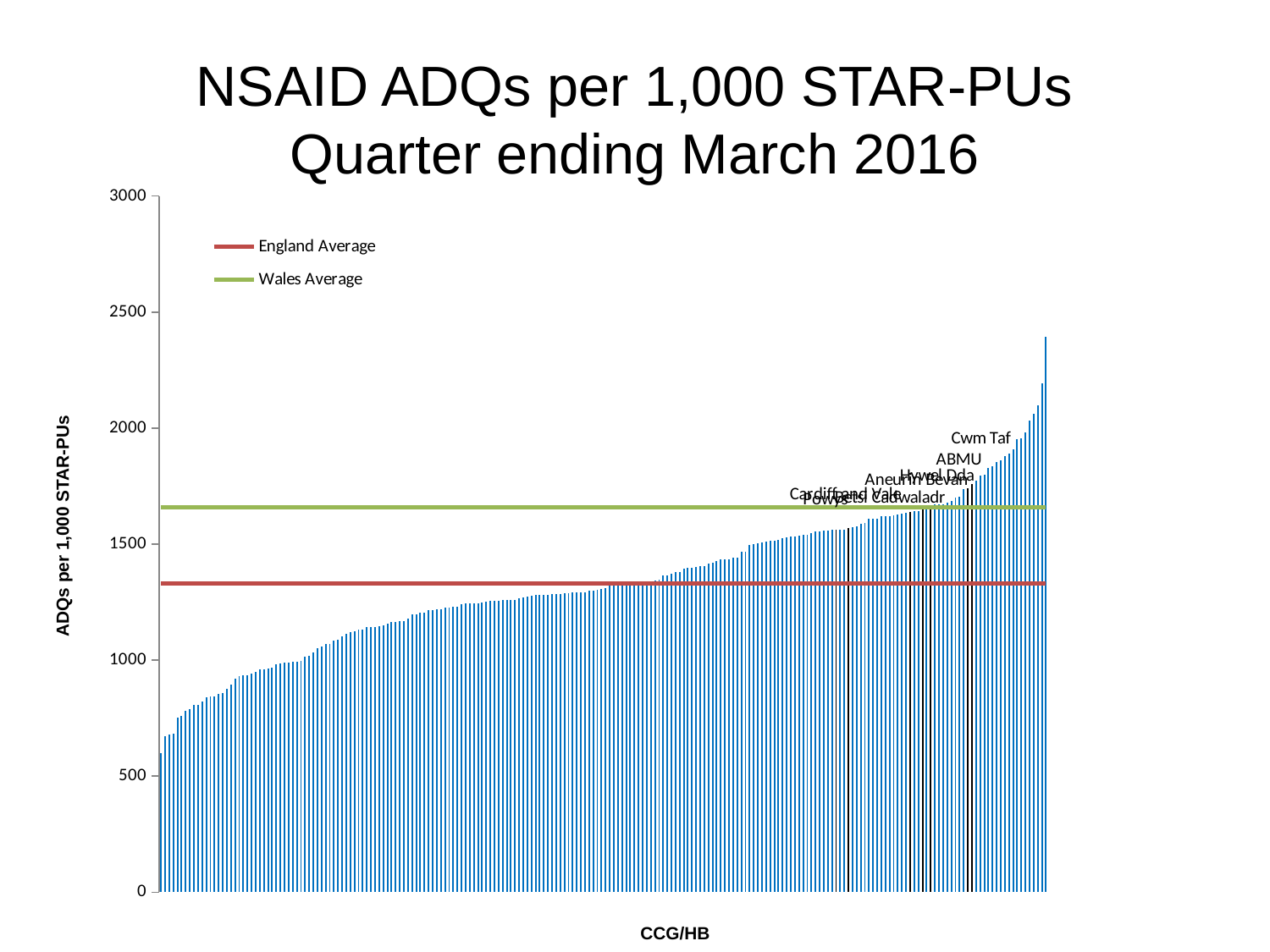
Is the value of the shortest bar greater or less than 1000? less Which is higher, the Wales Average line or the England Average line? Wales Average Is the England Average line greater or less than 1000? greater Is the England Average line greater or less than 1500? less Do the bar values rise or fall from left to right along the x axis? rise What kind of chart is shown on the slide? bar chart What is the label on the vertical axis? ADQs per 1,000 STAR-PUs What is the title of the chart? NSAID ADQs per 1,000 STAR-PUs Quarter ending March 2016 How many entries does the legend list? 2